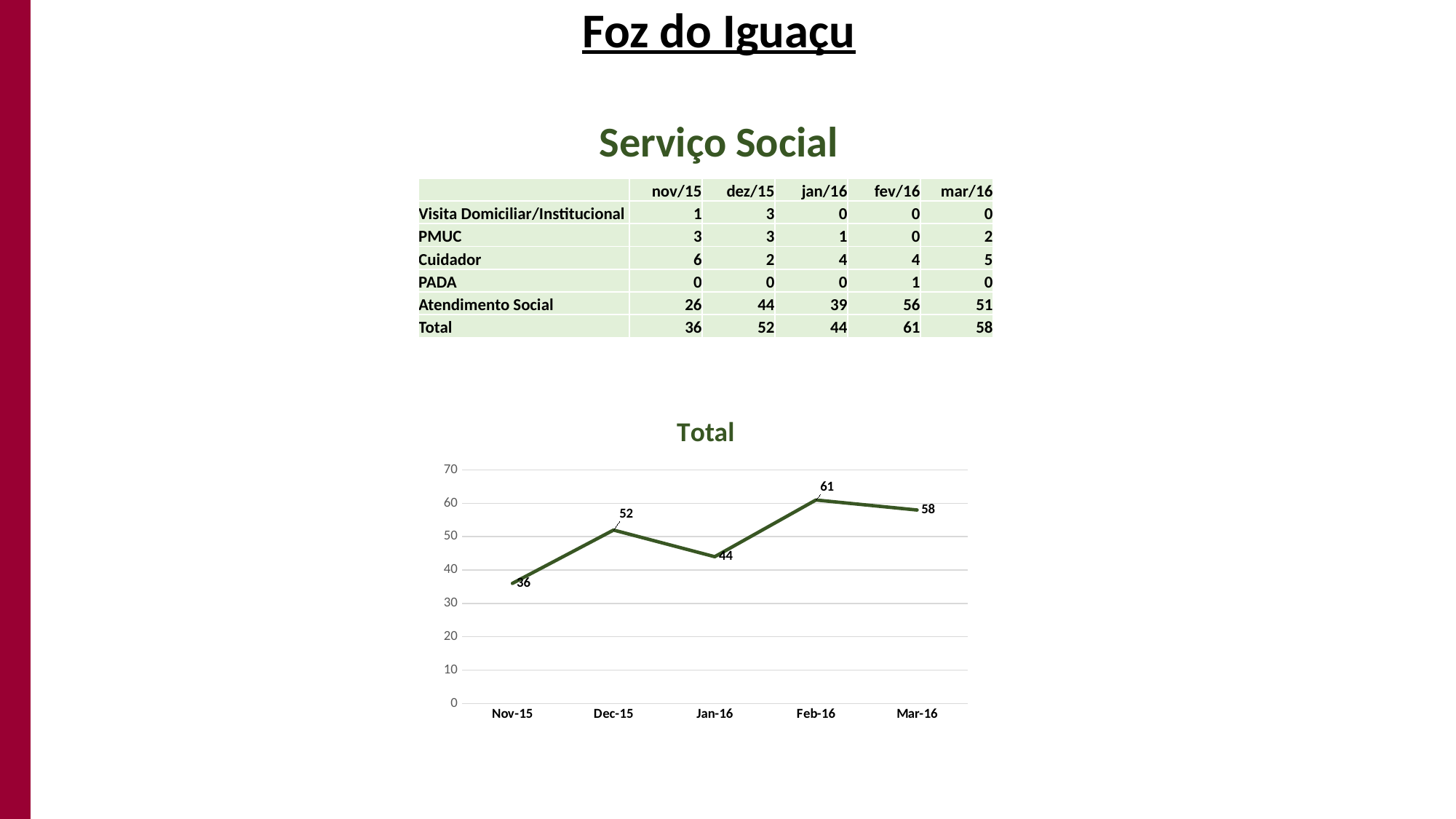
Which month has the highest value in the Total chart? Feb-16 What is the value for Jan-16 in the Total chart? 44 What is the difference between the Feb-16 and Nov-15 values in the Total chart? 25 Is the value for Mar-16 in the Total chart greater or less than 50? greater How many data points are plotted in the Total chart? 5 What is the difference between the Dec-15 and Jan-16 values in the Total chart? 8 What is the value for Feb-16 in the Total chart? 61 What is the value for Nov-15 in the Total chart? 36 What kind of chart is the Total chart? line chart Which is larger in the Total chart, the value for Dec-15 or the value for Mar-16? Mar-16 Which month has the lowest value in the Total chart? Nov-15 What is the title of the chart on the slide? Total